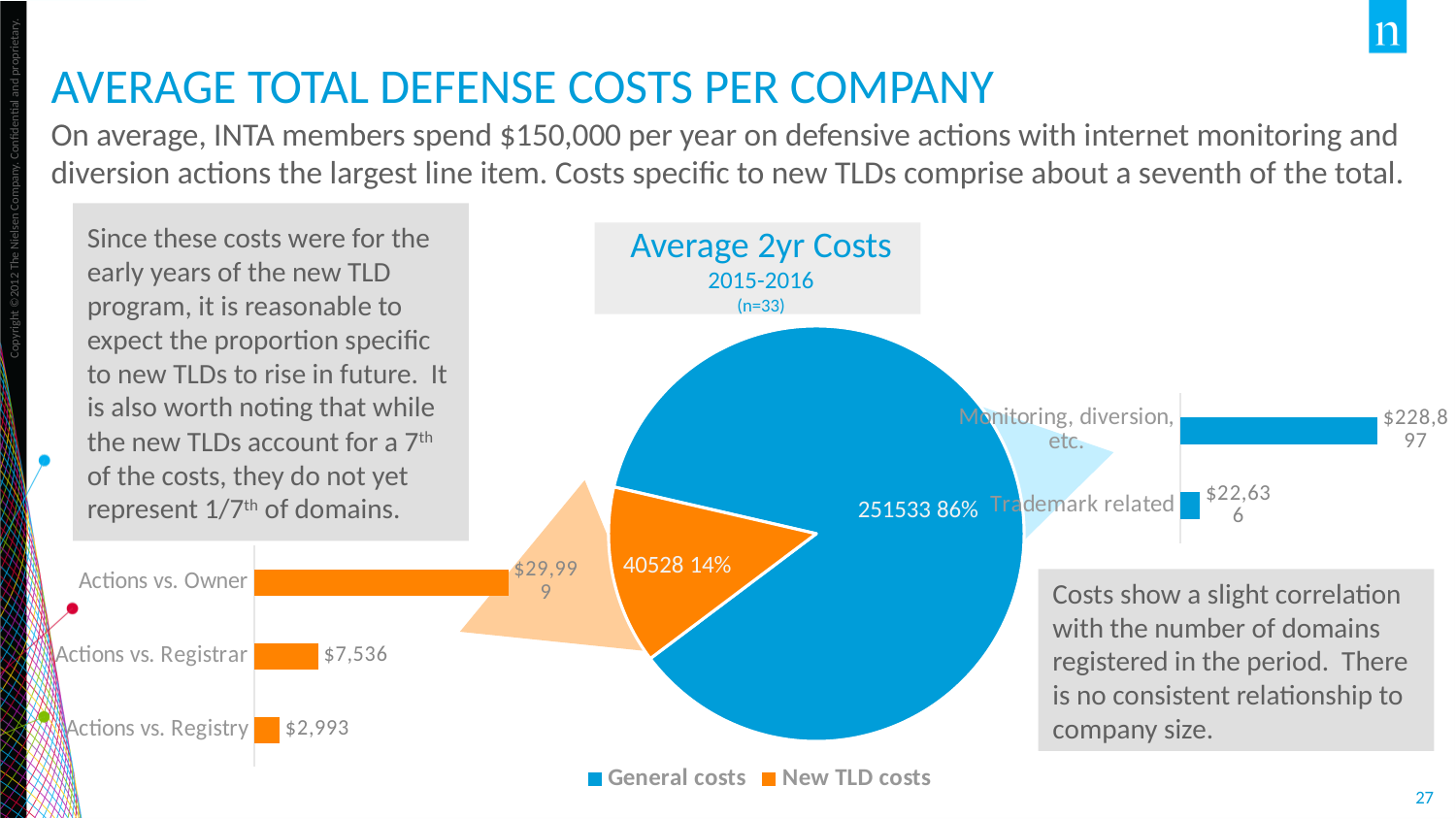
In the orange bar chart at the bottom left, what is the value for Actions vs. Owner? $29,999 In the orange bar chart at the bottom left, what is the difference between Actions vs. Owner and Actions vs. Registrar? $22,463 In the blue bar chart on the right, what is the value for Monitoring, diversion, etc.? $228,897 In the pie chart titled 'Average 2yr Costs', how many entries does the legend list? 2 In the pie chart titled 'Average 2yr Costs', what share of the total do General costs represent? 86% In the blue bar chart on the right, what is the value for Trademark related? $22,636 In the pie chart titled 'Average 2yr Costs', what value is shown for General costs? 251533 In the orange bar chart at the bottom left, what is the value for Actions vs. Registry? $2,993 In the orange bar chart at the bottom left, which category has the lowest value? Actions vs. Registry In the pie chart titled 'Average 2yr Costs', what value is shown for New TLD costs? 40528 In the pie chart titled 'Average 2yr Costs', which slice is larger, General costs or New TLD costs? General costs In the pie chart titled 'Average 2yr Costs', what share of the total do New TLD costs represent? 14%